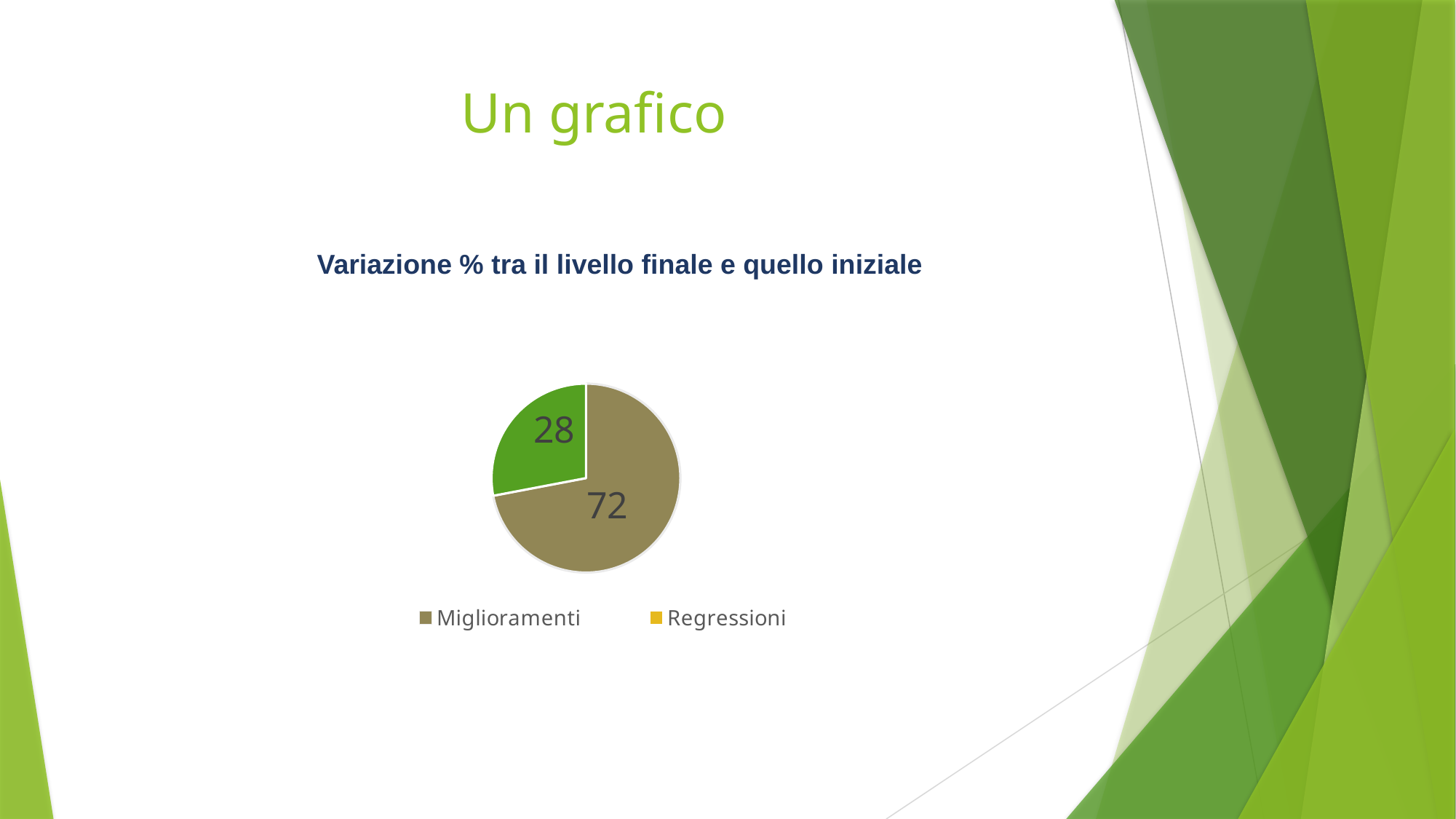
What is the value for Miglioramenti? 72 What is the title of the chart? Variazione % tra il livello finale e quello iniziale What share of the pie does Miglioramenti represent? 72% Which category has the largest slice? Miglioramenti How many entries does the legend list? 2 What kind of chart is shown on the slide? pie chart How many slices does the pie chart have? 2 What is the total of the two slice values? 100 Which is larger, Miglioramenti or Regressioni? Miglioramenti